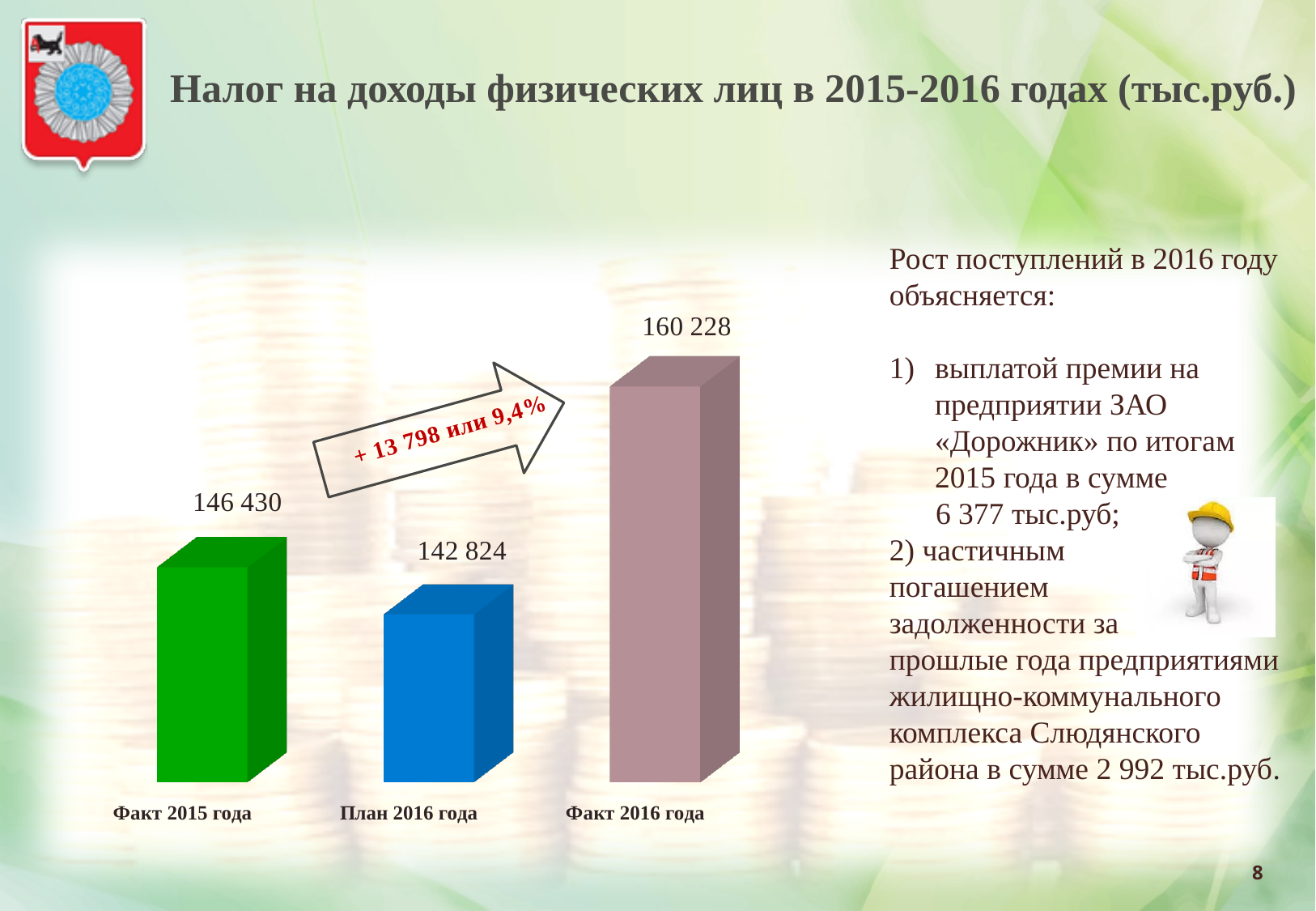
Which category has the highest value? Факт 2016 года What is the difference between Факт 2015 года and План 2016 года? 3 606 What is the value for План 2016 года? 142 824 What is the value for Факт 2015 года? 146 430 How many categories are shown in the chart? 3 Which category has the lowest value? План 2016 года What is the value for Факт 2016 года? 160 228 Which is larger, Факт 2015 года or План 2016 года? Факт 2015 года What kind of chart is shown on the slide? Bar chart What percentage growth is shown on the arrow in the chart? 9,4% What is the difference between Факт 2016 года and Факт 2015 года? 13 798 What is the title of the slide's chart? Налог на доходы физических лиц в 2015-2016 годах (тыс.руб.)